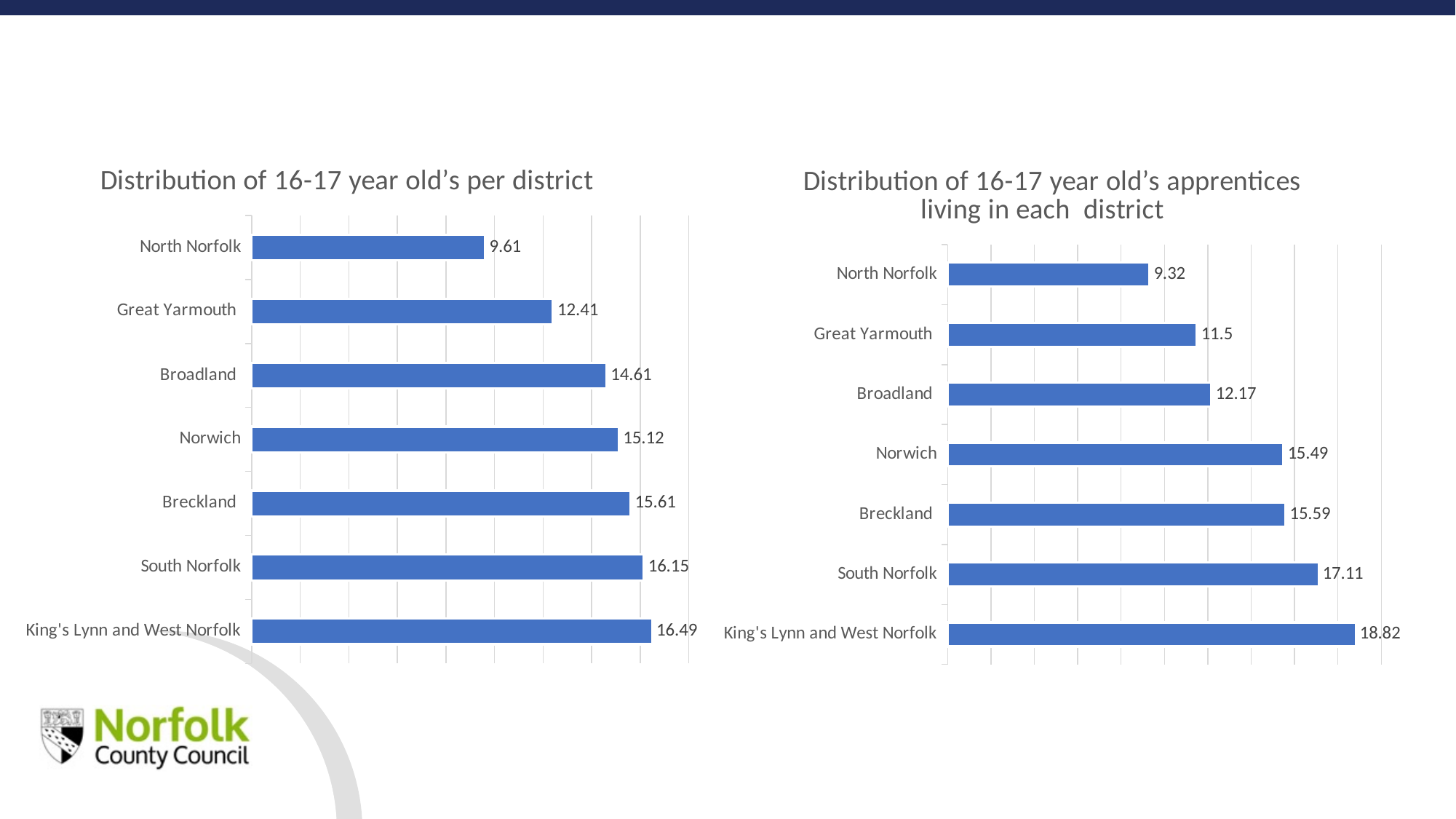
In the chart 'Distribution of 16-17 year old's per district', which district has the highest value? King's Lynn and West Norfolk In the chart 'Distribution of 16-17 year old's apprentices living in each district', which is larger, the value for Norwich or the value for Great Yarmouth? Norwich In the chart 'Distribution of 16-17 year old's apprentices living in each district', what is the value for Great Yarmouth? 11.5 In the chart 'Distribution of 16-17 year old's per district', what is the value for Breckland? 15.61 How many charts are shown on the slide? 2 In the chart 'Distribution of 16-17 year old's per district', what is the difference between the values for King's Lynn and West Norfolk and North Norfolk? 6.88 In the chart 'Distribution of 16-17 year old's apprentices living in each district', what is the value for King's Lynn and West Norfolk? 18.82 How many districts are shown in the chart 'Distribution of 16-17 year old's per district'? 7 What kind of chart is 'Distribution of 16-17 year old's apprentices living in each district'? Bar chart In the chart 'Distribution of 16-17 year old's apprentices living in each district', which district has the lowest value? North Norfolk In the chart 'Distribution of 16-17 year old's per district', what is the value for Norwich? 15.12 In the chart 'Distribution of 16-17 year old's apprentices living in each district', what is the difference between the values for South Norfolk and Broadland? 4.94